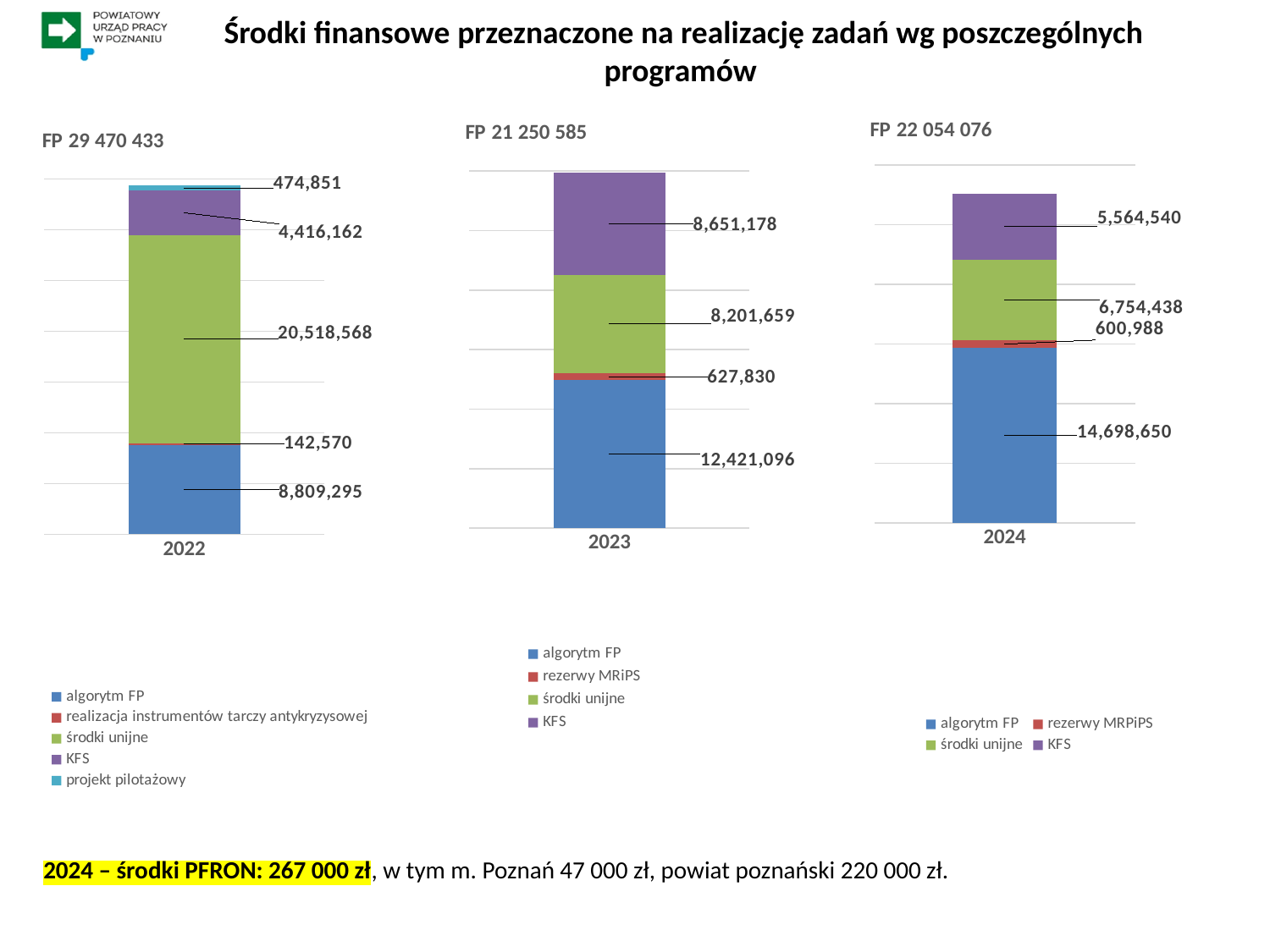
What type of chart is the 2023 chart (FP 21 250 585)? stacked bar chart In the 2022 chart (FP 29 470 433), what is the value of the środki unijne segment? 20,518,568 In the 2022 chart (FP 29 470 433), what is the value of the projekt pilotażowy segment? 474,851 In the 2024 chart (FP 22 054 076), what is the difference between the algorytm FP segment and the środki unijne segment? 7,944,212 In the 2022 chart (FP 29 470 433), which segment has the largest value? środki unijne In the 2024 chart (FP 22 054 076), what colour is the KFS segment? purple In the 2023 chart (FP 21 250 585), what is the difference between the KFS segment and the środki unijne segment? 449,519 In the 2024 chart (FP 22 054 076), what is the value of the rezerwy MRPiPS segment? 600,988 How many series does the legend of the 2022 chart (FP 29 470 433) list? 5 In the 2023 chart (FP 21 250 585), which segment has the smallest value? rezerwy MRiPS In the 2024 chart (FP 22 054 076), which is larger: środki unijne or KFS? środki unijne In the 2023 chart (FP 21 250 585), what is the value of the algorytm FP segment? 12,421,096